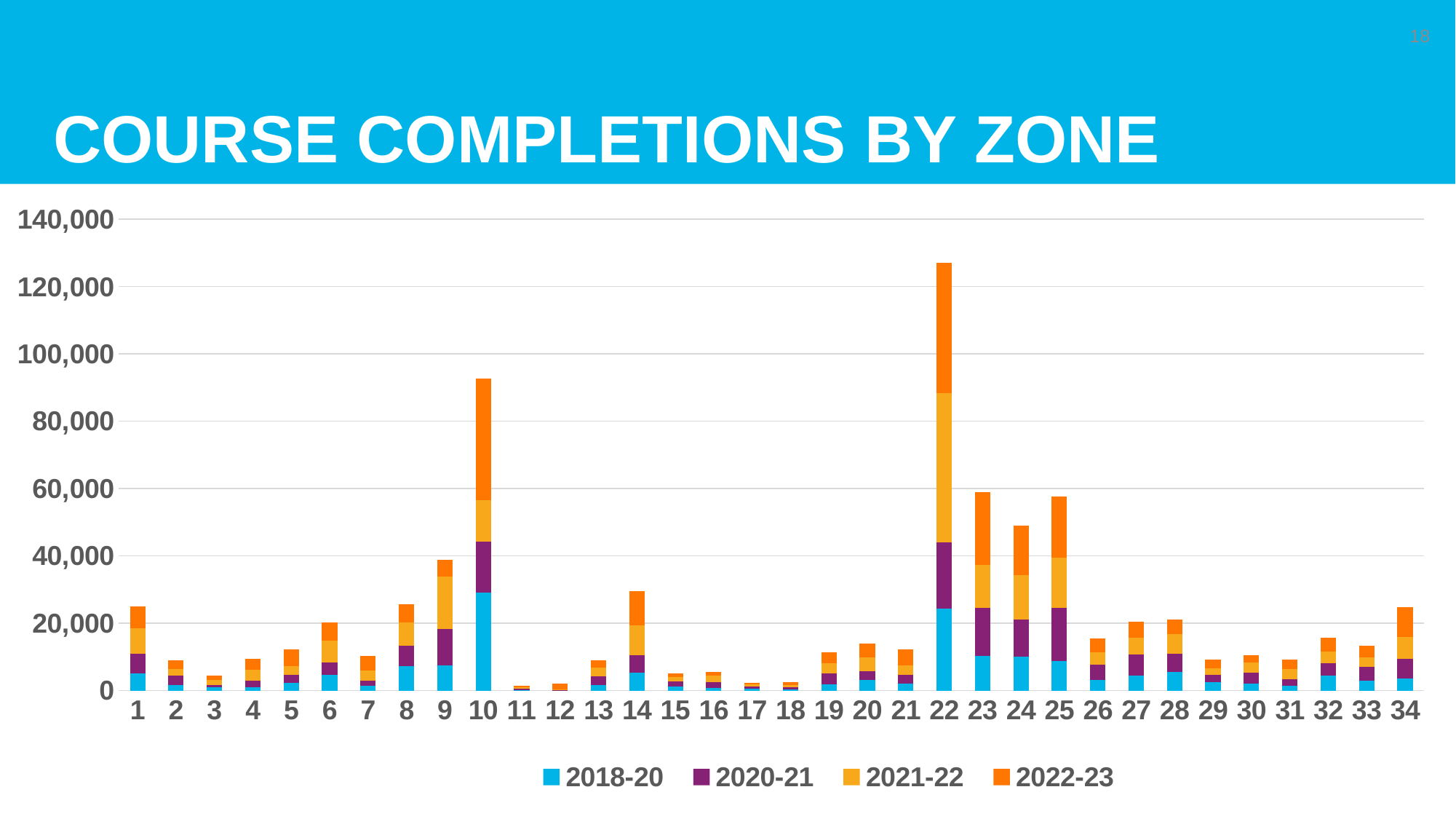
Which zone has the highest total course completions? 22 Is the total for zone 10 greater or less than 80,000? greater Which zone has the larger total, zone 23 or zone 24? 23 Which zone has the larger total, zone 10 or zone 22? 22 Is the total for zone 14 greater or less than 20,000? greater How many series does the legend list? 4 What is the title of the chart? COURSE COMPLETIONS BY ZONE What kind of chart is shown on the slide? Stacked bar chart Which series is shown in light blue in the legend? 2018-20 Is the total for zone 22 greater or less than 120,000? greater How many zones are shown on the x axis? 34